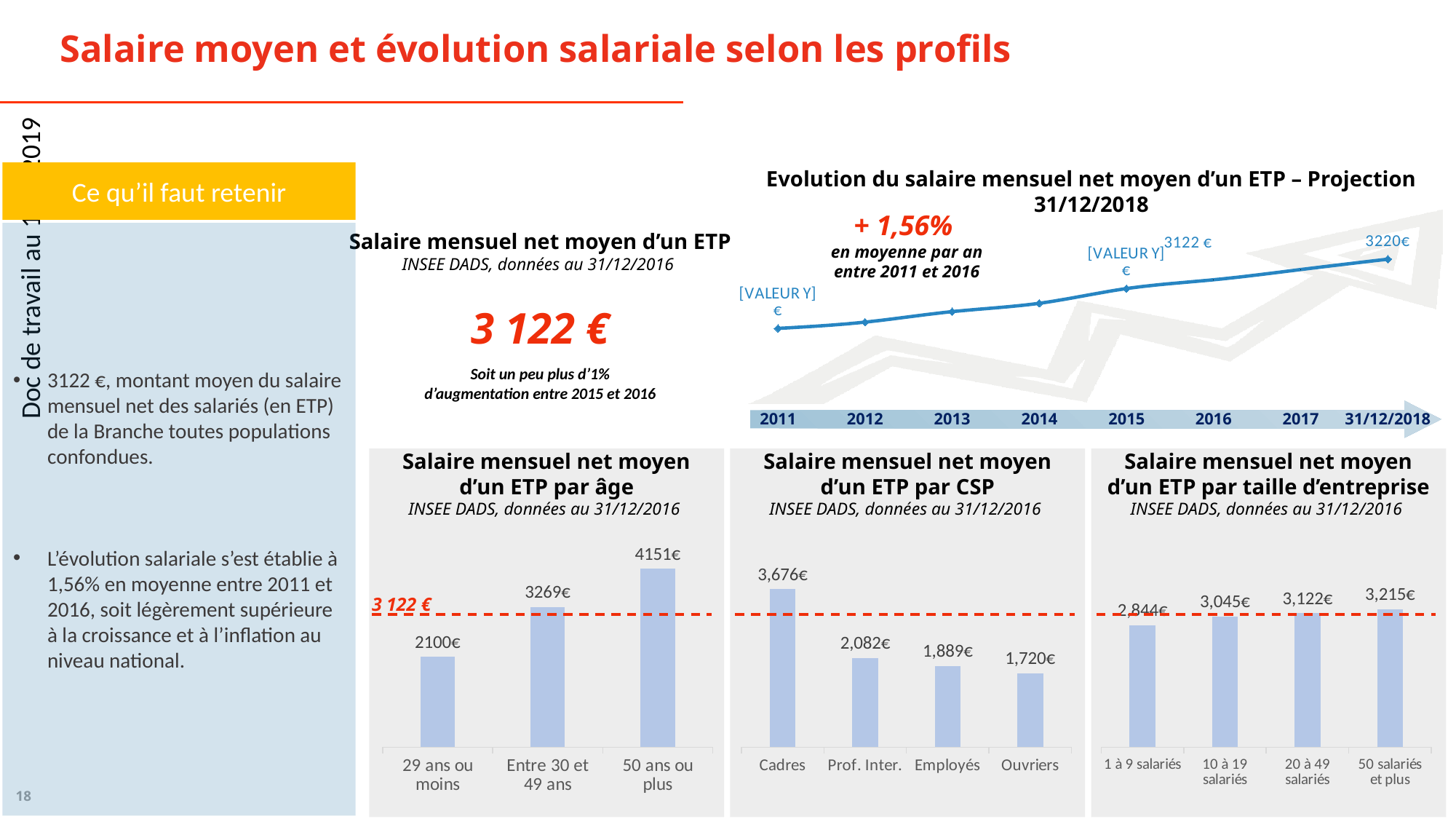
In the chart 'Salaire mensuel net moyen d'un ETP par CSP', which category has the lowest value? Ouvriers What kind of chart is 'Evolution du salaire mensuel net moyen d'un ETP – Projection 31/12/2018'? line chart In the chart 'Salaire mensuel net moyen d'un ETP par taille d'entreprise', do the values rise or fall from left to right? rise In the chart 'Salaire mensuel net moyen d'un ETP par CSP', which is larger: 'Prof. Inter.' or 'Employés'? Prof. Inter. In the chart 'Salaire mensuel net moyen d'un ETP par CSP', how many categories are shown? 4 In the chart 'Salaire mensuel net moyen d'un ETP par âge', which age group has the lowest value? 29 ans ou moins In the chart 'Salaire mensuel net moyen d'un ETP par âge', what is the value for '50 ans ou plus'? 4151€ In the chart 'Salaire mensuel net moyen d'un ETP par CSP', what is the value for 'Cadres'? 3,676€ In the chart 'Salaire mensuel net moyen d'un ETP par taille d'entreprise', what is the value for '10 à 19 salariés'? 3,045€ In the chart 'Salaire mensuel net moyen d'un ETP par taille d'entreprise', which category has the highest value? 50 salariés et plus In the chart 'Evolution du salaire mensuel net moyen d'un ETP – Projection 31/12/2018', what is the value shown for 31/12/2018? 3220€ In the chart 'Salaire mensuel net moyen d'un ETP par âge', what is the difference between 'Entre 30 et 49 ans' and '29 ans ou moins'? 1169€